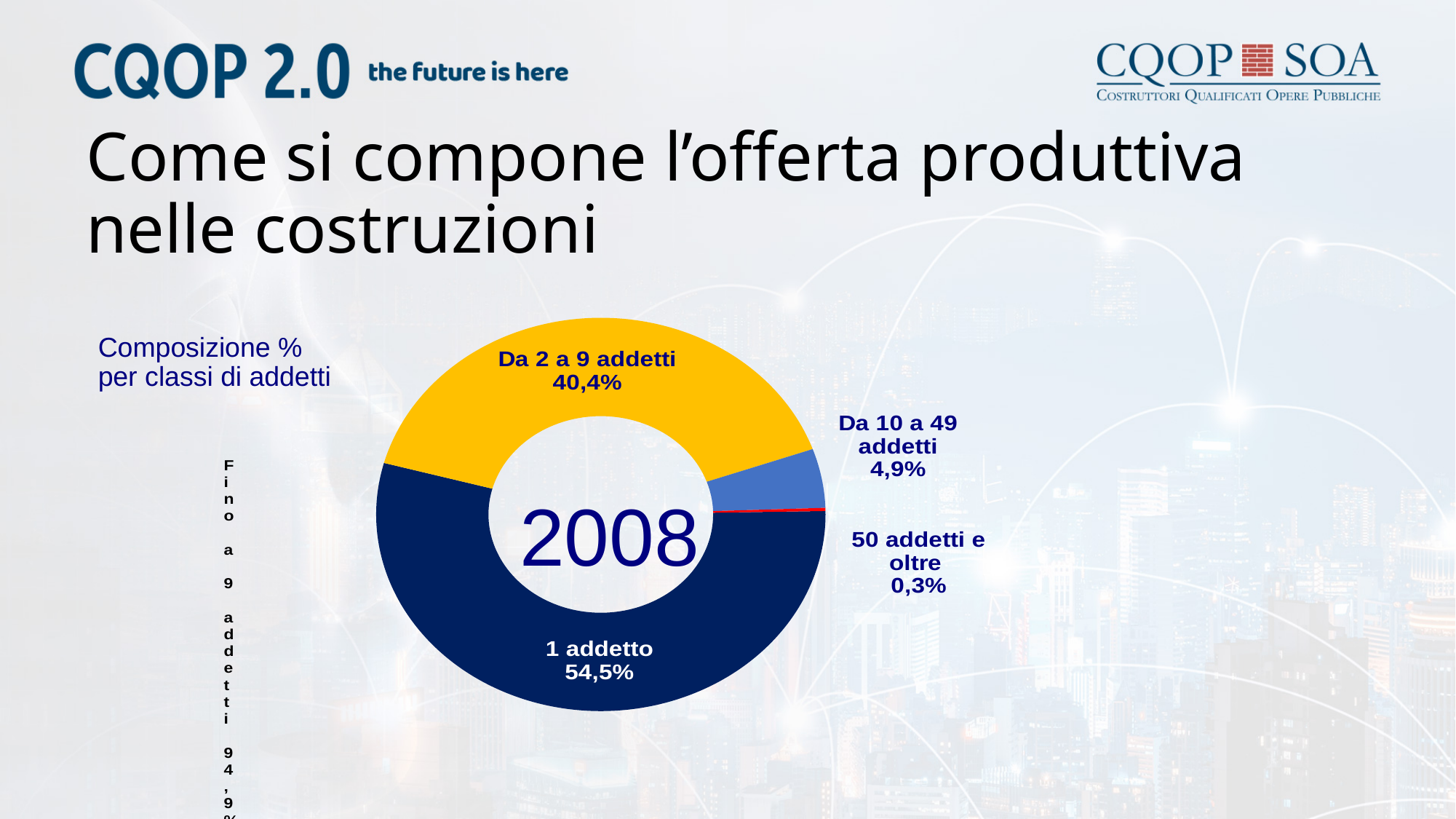
What percentage is shown for 'Da 2 a 9 addetti'? 40,4% What is the combined share of '1 addetto' and 'Da 2 a 9 addetti'? 94,9% What kind of chart is shown on the slide? doughnut chart What is the difference in percentage points between '1 addetto' and 'Da 2 a 9 addetti'? 14,1 What share of the doughnut chart is labelled '1 addetto'? 54,5% What percentage is shown for 'Da 10 a 49 addetti'? 4,9% How many slices does the chart have? 4 Which class of addetti has the largest share in the chart? 1 addetto Which is larger: the share for 'Da 10 a 49 addetti' or for '50 addetti e oltre'? Da 10 a 49 addetti What year is written in the centre of the doughnut chart? 2008 Which class of addetti has the smallest share in the chart? 50 addetti e oltre What percentage is shown for '50 addetti e oltre'? 0,3%